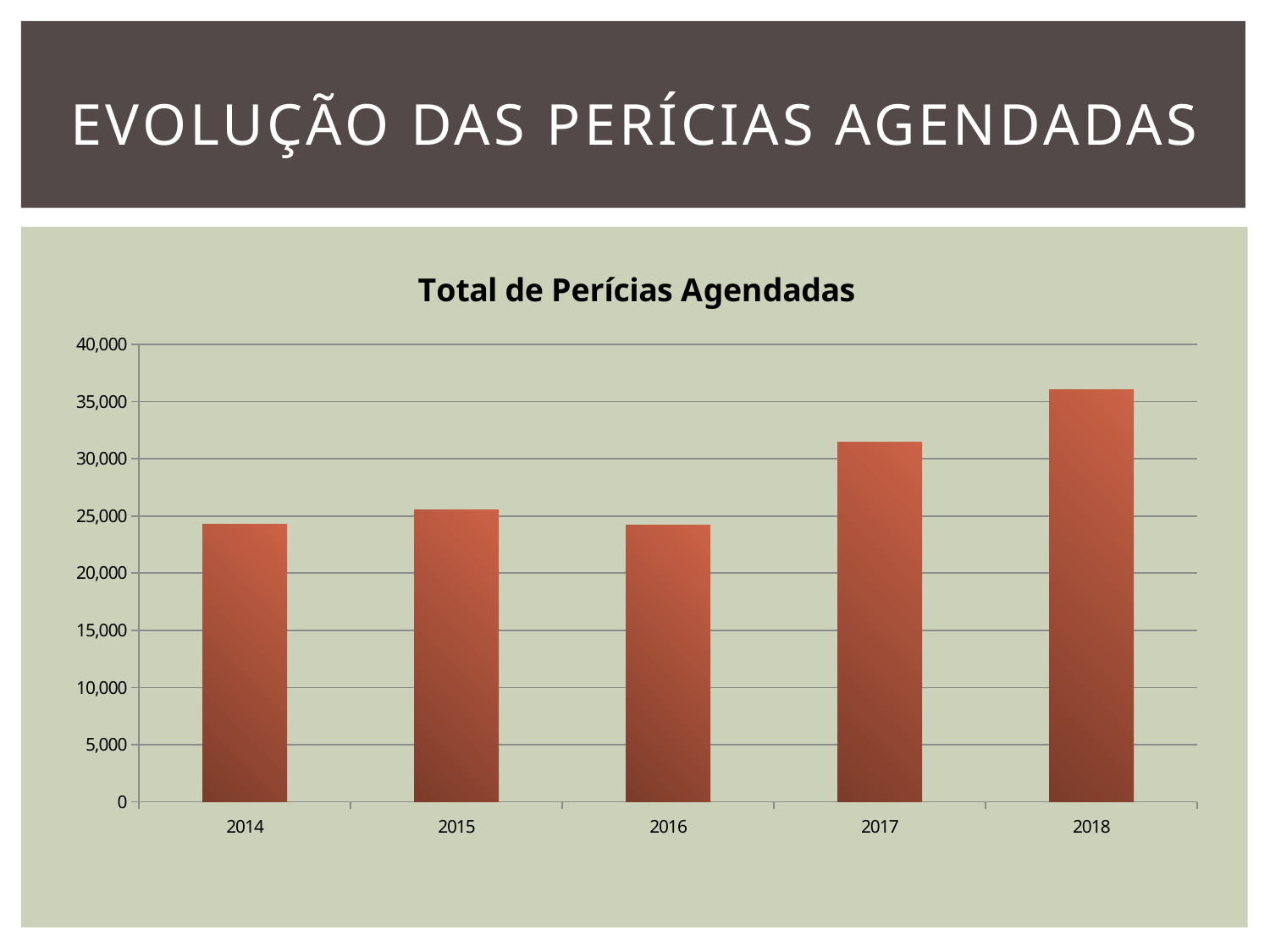
Which is larger, the value for 2017 or the value for 2018? 2018 Is the value for 2017 greater or less than 35,000? less How many years are shown on the x axis of the chart? 5 Is the value for 2014 greater or less than 25,000? less Is the value for 2017 greater or less than 30,000? greater Which is larger, the value for 2015 or the value for 2017? 2017 What kind of chart is shown on the slide? bar chart Which year has the highest total of perícias agendadas? 2018 Do the values rise or fall from 2016 to 2018? rise What is the title of the chart? Total de Perícias Agendadas